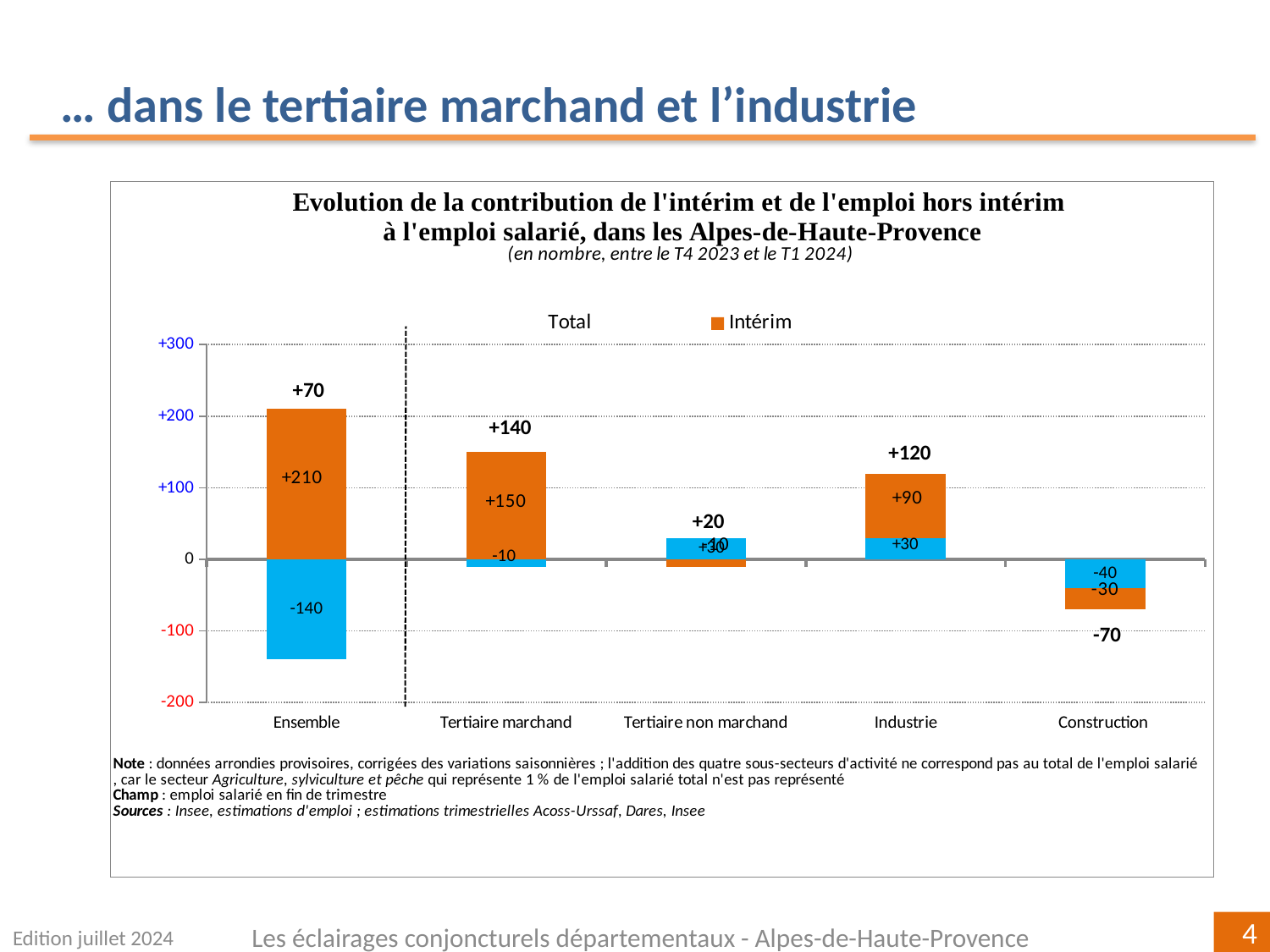
Which category has the highest total value? Tertiaire marchand What is the total value shown for Tertiaire marchand? +140 What is the difference between the total value for Industrie and the total value for Tertiaire non marchand? 100 What is the Intérim value for Construction? -30 What kind of chart is shown on the slide? bar chart What is the total value shown for Construction? -70 Which category has the lowest total value? Construction What is the Intérim value for Industrie? +90 How many categories are shown on the x axis of the chart? 5 Which has the larger Intérim value, Ensemble or Tertiaire marchand? Ensemble What is the Intérim value for Ensemble? +210 Which department is named in the chart title? Alpes-de-Haute-Provence